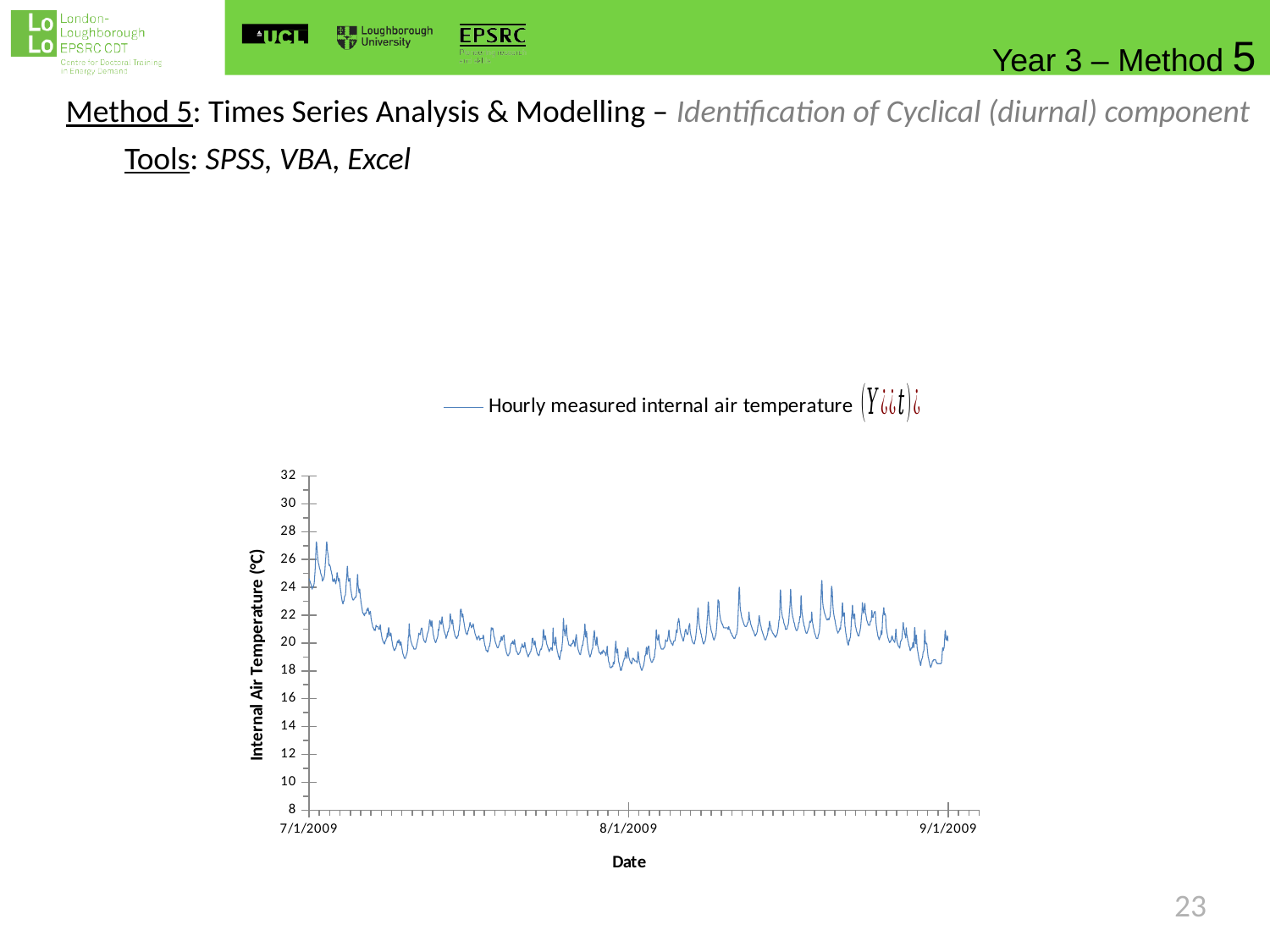
What is the highest value shown on the y axis of the chart? 32 How many series does the chart's legend list? 1 Is the lowest internal air temperature plotted greater or less than 16? greater Is the highest internal air temperature plotted greater or less than 30? less Does the internal air temperature generally rise or fall between 7/1/2009 and 8/1/2009? fall What kind of chart is shown on the slide? line chart Is the internal air temperature at the start of the series (7/1/2009) greater or less than 22? greater What is the label of the x axis of the chart? Date Which is larger, the internal air temperature at 7/1/2009 or at 8/1/2009? 7/1/2009 What is the label of the y axis of the chart? Internal Air Temperature (°C)